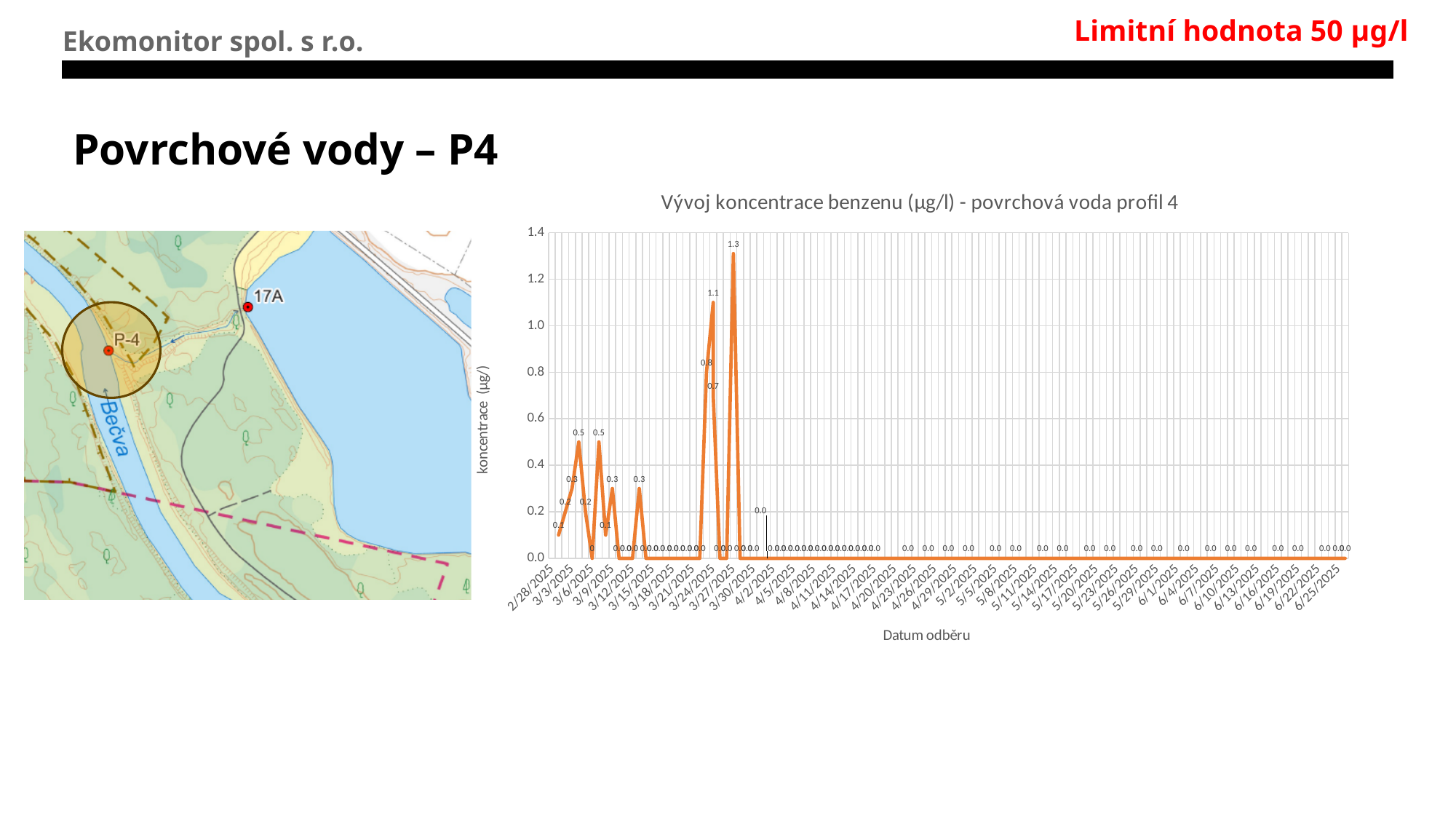
What is the highest benzene concentration value plotted on the chart? 1.3 What is the label of the vertical axis of the chart? koncentrace (µg/l) What is the title of the chart? Vývoj koncentrace benzenu (µg/l) - povrchová voda profil 4 Is the highest value on the chart greater or less than 1.0? greater Is the highest plotted value greater or less than the limit value of 50 µg/l stated on the slide? less What is the last date shown on the x axis of the chart? 6/25/2025 What is the highest tick value on the vertical axis of the chart? 1.4 What kind of chart is shown on the slide? line chart What is the first date shown on the x axis of the chart? 2/28/2025 What is the difference between the two highest peaks on the chart, 1.3 and 1.1? 0.2 Do the plotted concentration values overall rise or fall from March to June 2025? fall